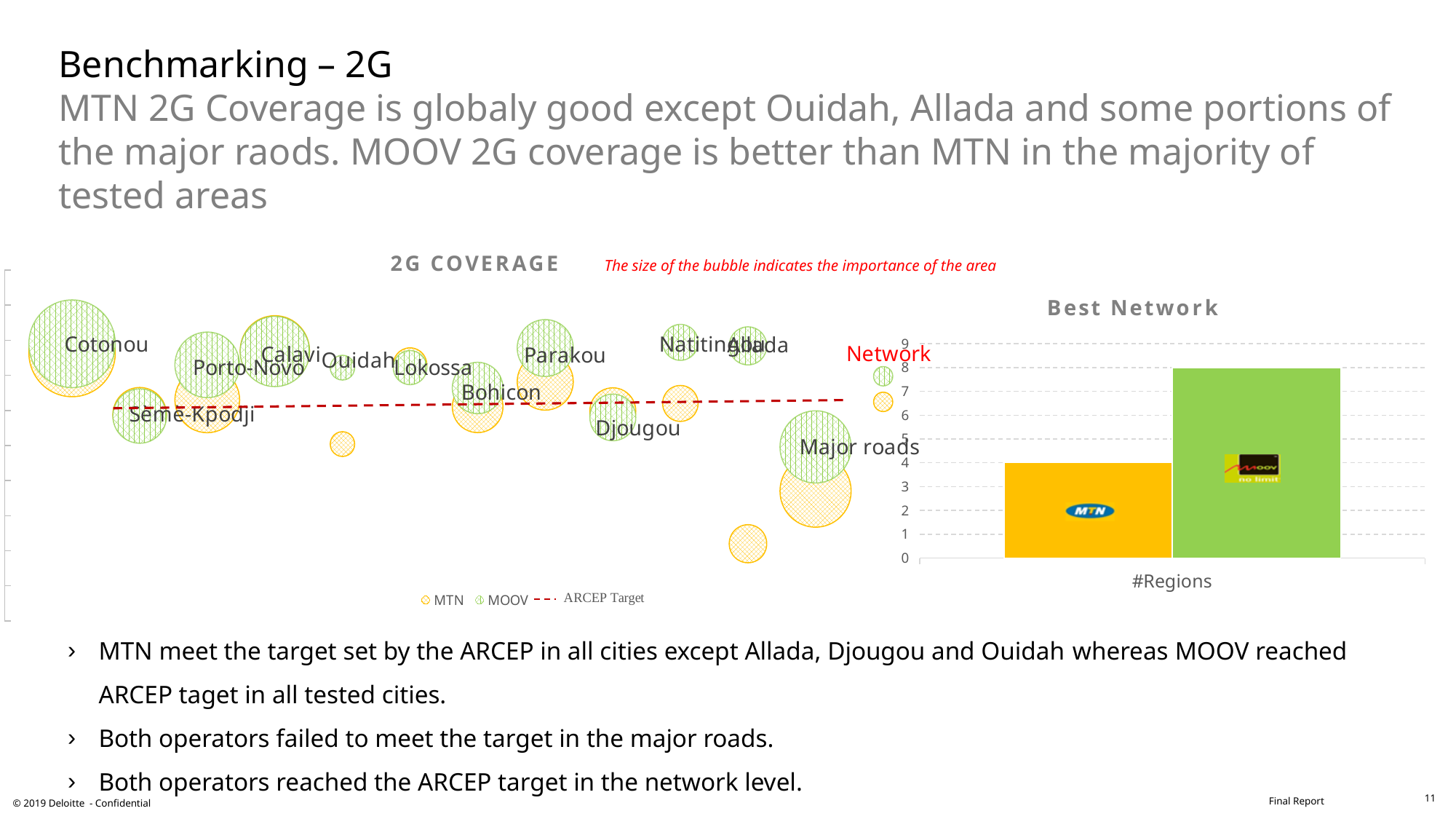
In the Best Network chart, what is the value for MTN? 4 In the Best Network chart, which operator has the higher number of regions? MOOV In the Best Network chart, what is the label shown under the x axis? #Regions How many entries does the legend of the 2G COVERAGE chart list? 3 What kind of chart is the 2G COVERAGE chart? bubble chart In the Best Network chart, how many bars are plotted? 2 In the Best Network chart, which operator has the lower number of regions? MTN In the Best Network chart, is the MTN bar taller or shorter than the MOOV bar? shorter In the Best Network chart, what is the difference between the MOOV value and the MTN value? 4 In the 2G COVERAGE chart, what does the size of a bubble indicate according to the note on the slide? The importance of the area What kind of chart is the Best Network chart? bar chart In the Best Network chart, what is the value for MOOV? 8